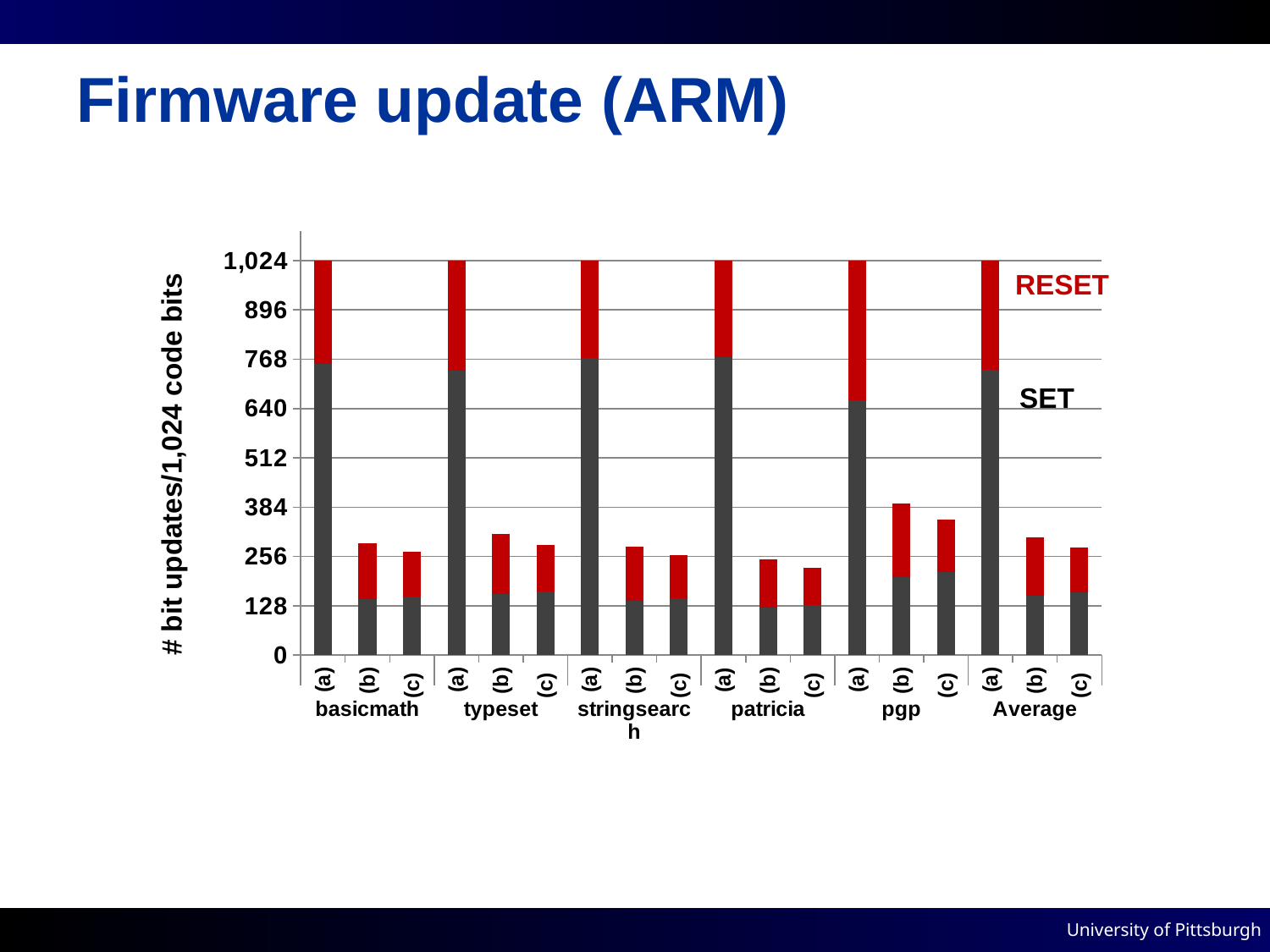
Is the total for pgp (c) greater or less than 384? less Is the total for patricia (c) greater or less than 256? less Is the total for basicmath (b) greater or less than 256? greater Which colour represents the RESET series? red What are the two series named in the legend? RESET and SET How many bars are plotted in total? 18 What is the total height of the basicmath (a) bar? 1,024 How many benchmark groups are shown along the x axis? 6 What kind of chart is shown on the slide? stacked bar chart How many series does the legend list? 2 Which is larger, the total for pgp (b) or the total for pgp (c)? pgp (b) Among the (c) bars, which benchmark has the lowest total? patricia